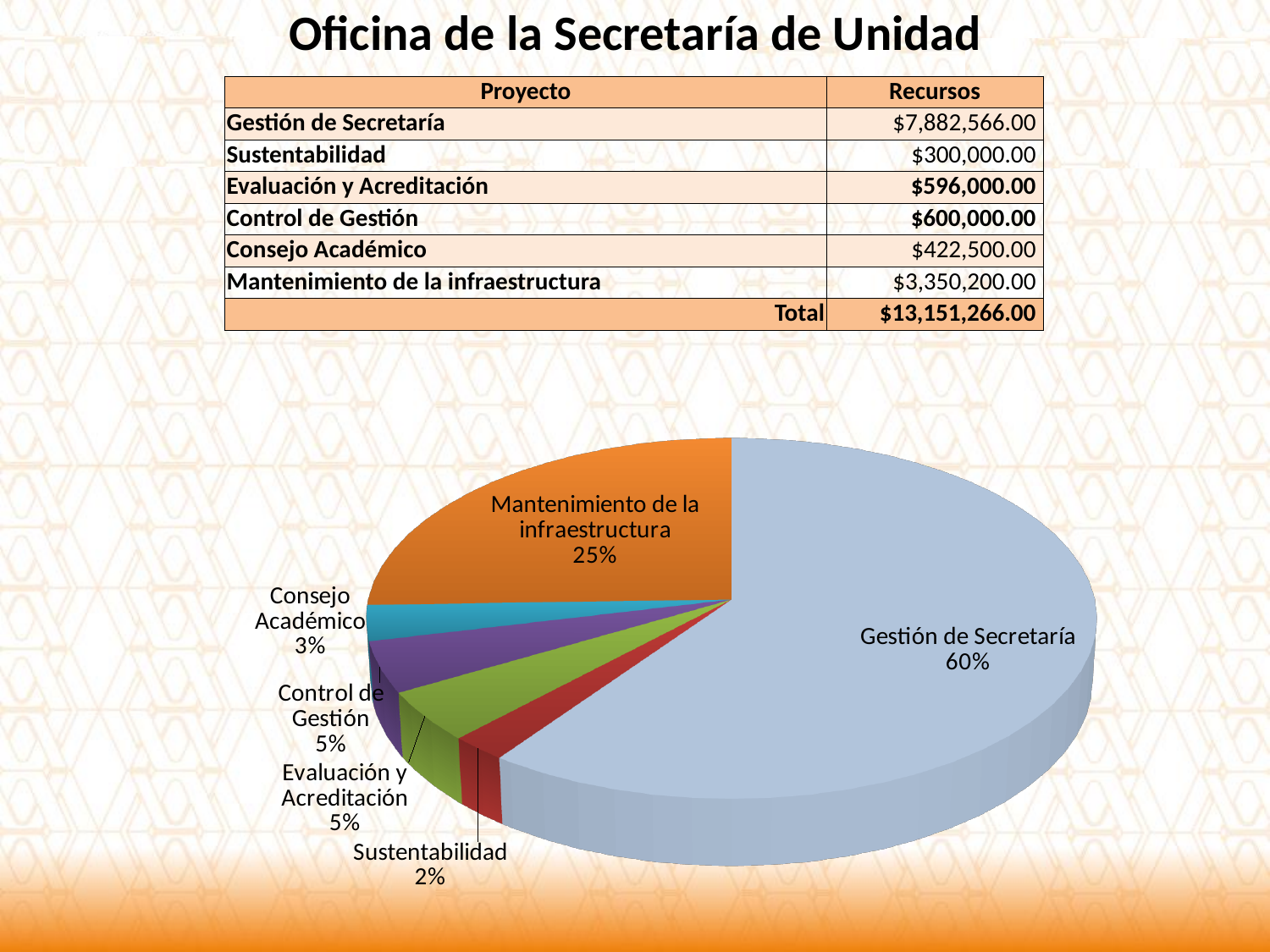
What kind of chart is shown on the slide? Pie chart Which project has the largest slice of the pie chart? Gestión de Secretaría What percentage is shown for Sustentabilidad in the pie chart? 2% What share of the pie does Gestión de Secretaría represent? 60% What is the title of the slide containing the pie chart? Oficina de la Secretaría de Unidad Which project has the smallest slice of the pie chart? Sustentabilidad By how many percentage points does the Gestión de Secretaría slice exceed the Mantenimiento de la infraestructura slice? 35 percentage points What percentage is shown for Control de Gestión in the pie chart? 5% Which slice is larger in the pie chart, Mantenimiento de la infraestructura or Consejo Académico? Mantenimiento de la infraestructura What percentage is shown for Consejo Académico in the pie chart? 3% How many slices does the pie chart have? 6 What share of the pie does Mantenimiento de la infraestructura represent? 25%